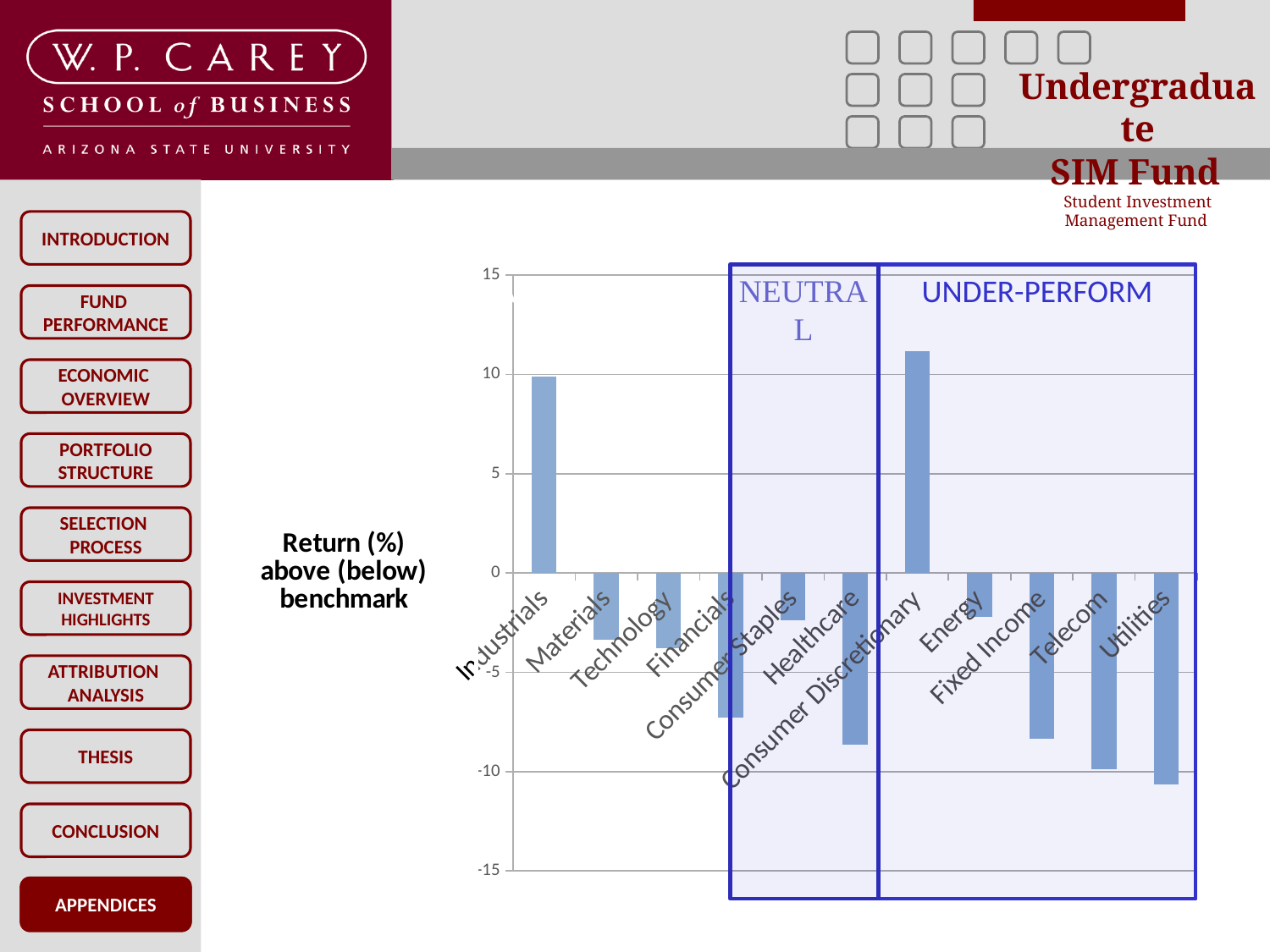
Is the value for Industrials greater or less than 5? greater Is the value for Materials greater or less than -5? greater Which category has the lowest return relative to benchmark? Utilities What label is shown to the left of the chart describing what the values represent? Return (%) above (below) benchmark What kind of chart is shown on the slide? bar chart How many sectors/categories are plotted on the chart? 11 Which category has the highest return above benchmark? Consumer Discretionary Is the value for Consumer Staples greater or less than -5? greater Which is larger, the value for Energy or the value for Industrials? Industrials Which is larger, the value for Healthcare or the value for Consumer Discretionary? Consumer Discretionary